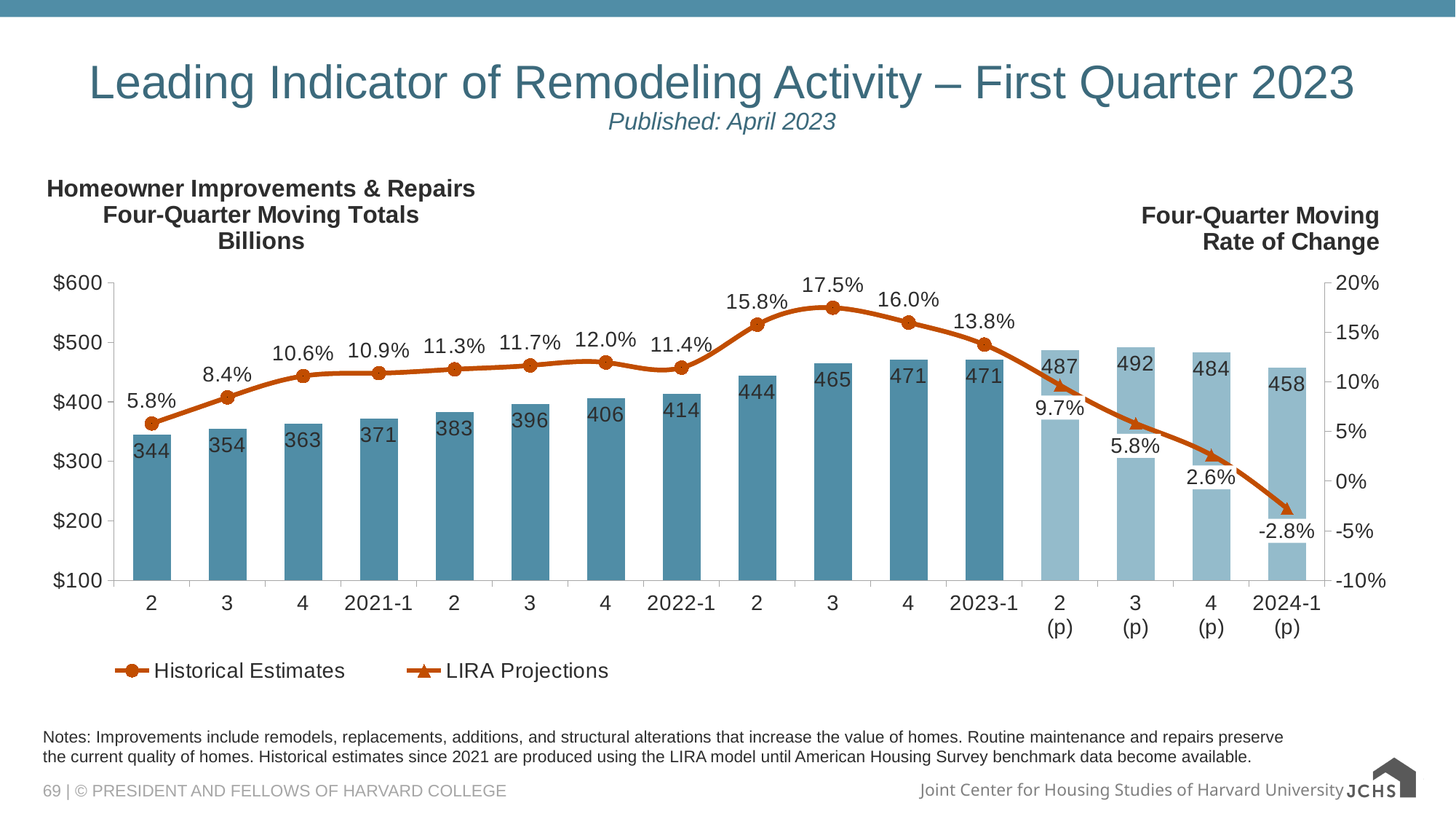
What is the four-quarter moving total (in billions) shown for 2023-1? 471 What is the four-quarter moving rate of change shown for the third quarter of 2022? 17.5% What is the difference between the highest bar (492) and the lowest bar (344)? 148 What kind of chart is this? A combination bar and line chart Which is larger, the moving total for 2022-1 or for the fourth quarter of 2021? 2022-1 (414 vs 406) What is the projected rate of change shown for 2024-1 (p)? -2.8% Which period has the lowest four-quarter moving rate of change? 2024-1 (p), at -2.8% Which period has the highest four-quarter moving total bar? 3 (p) of 2023, at 492 What are the two entries in the chart legend? Historical Estimates and LIRA Projections Does the rate of change line rise or fall from 2023-1 to 2024-1 (p)? Fall How many bars (periods) are plotted on the chart? 16 How many series does the legend list? 2